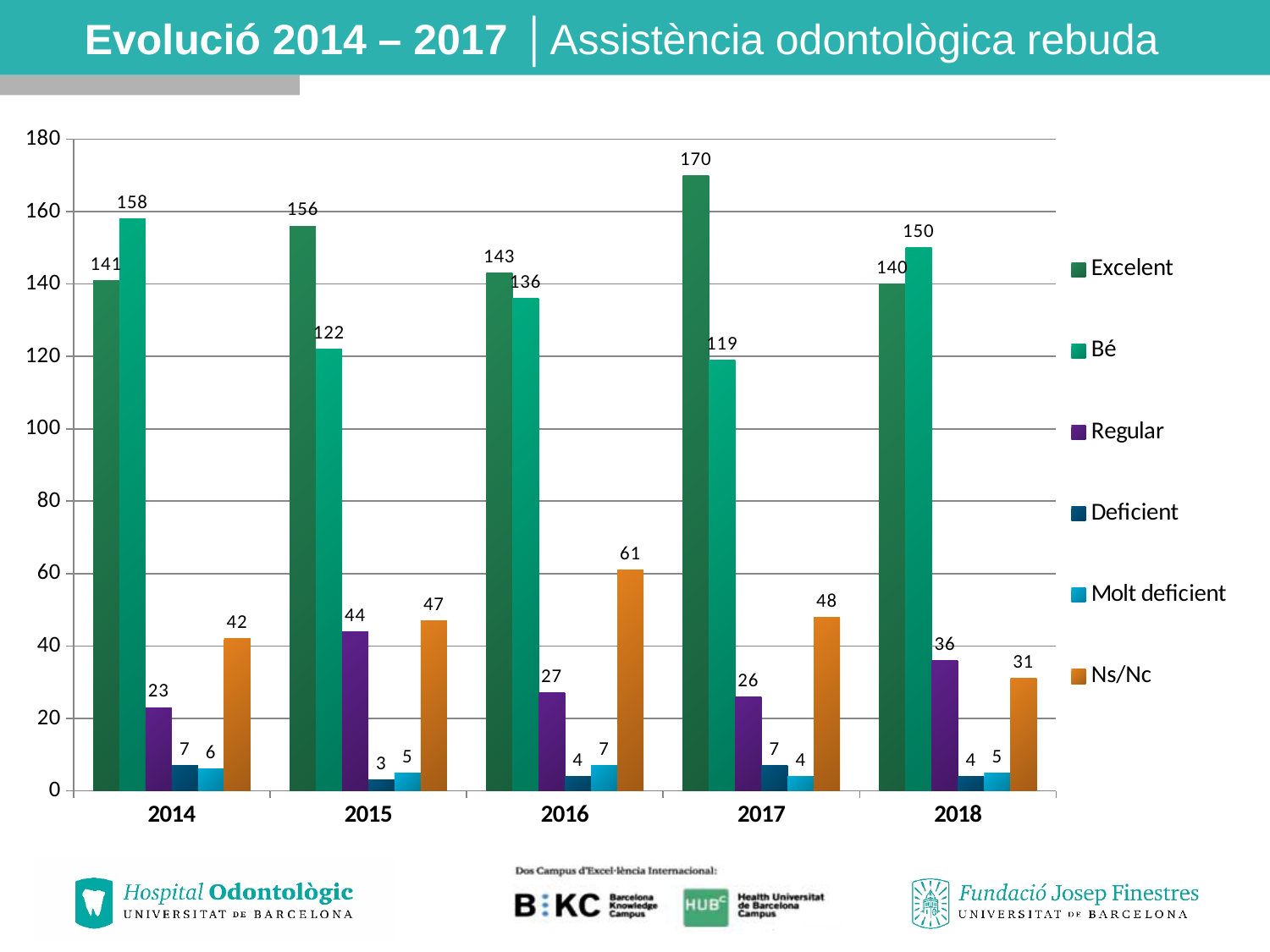
Does the Ns/Nc value rise or fall from 2016 to 2018? Fall What is the value for Ns/Nc in 2016? 61 In which year is the Bé value lowest? 2017 What is the value for Regular in 2015? 44 In which year is the Excelent value highest? 2017 What kind of chart is shown on the slide? Bar chart Which is larger in 2014, Excelent or Bé? Bé What is the difference between the Excelent and Bé values in 2017? 51 Which legend entry is shown in orange? Ns/Nc How many years are shown on the x axis? 5 What is the value for Excelent in 2017? 170 How many series does the legend list? 6